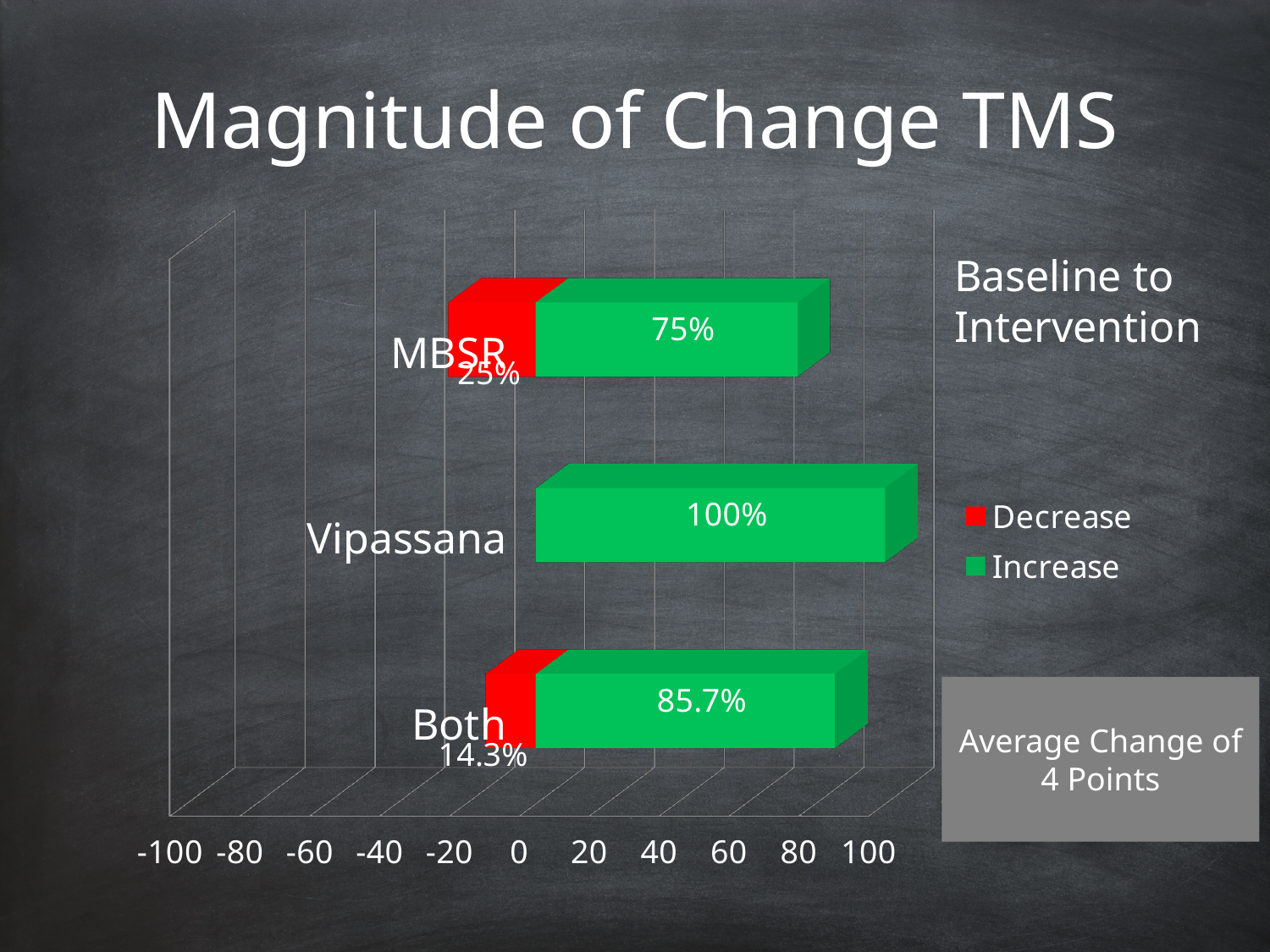
What is the difference between the Increase values for Vipassana and MBSR? 25% How many categories are shown on the chart? 3 What is the Decrease value for Both? 14.3% What is the Increase value for MBSR? 75% How many series does the legend list? 2 Which category has the highest Increase value? Vipassana Which category has the lowest Increase value? MBSR What is the Increase value for Vipassana? 100% Which is larger, the Decrease value for MBSR or the Decrease value for Both? MBSR What kind of chart is shown on the slide? Bar chart What is the Decrease value for MBSR? 25% What is the Increase value for Both? 85.7%